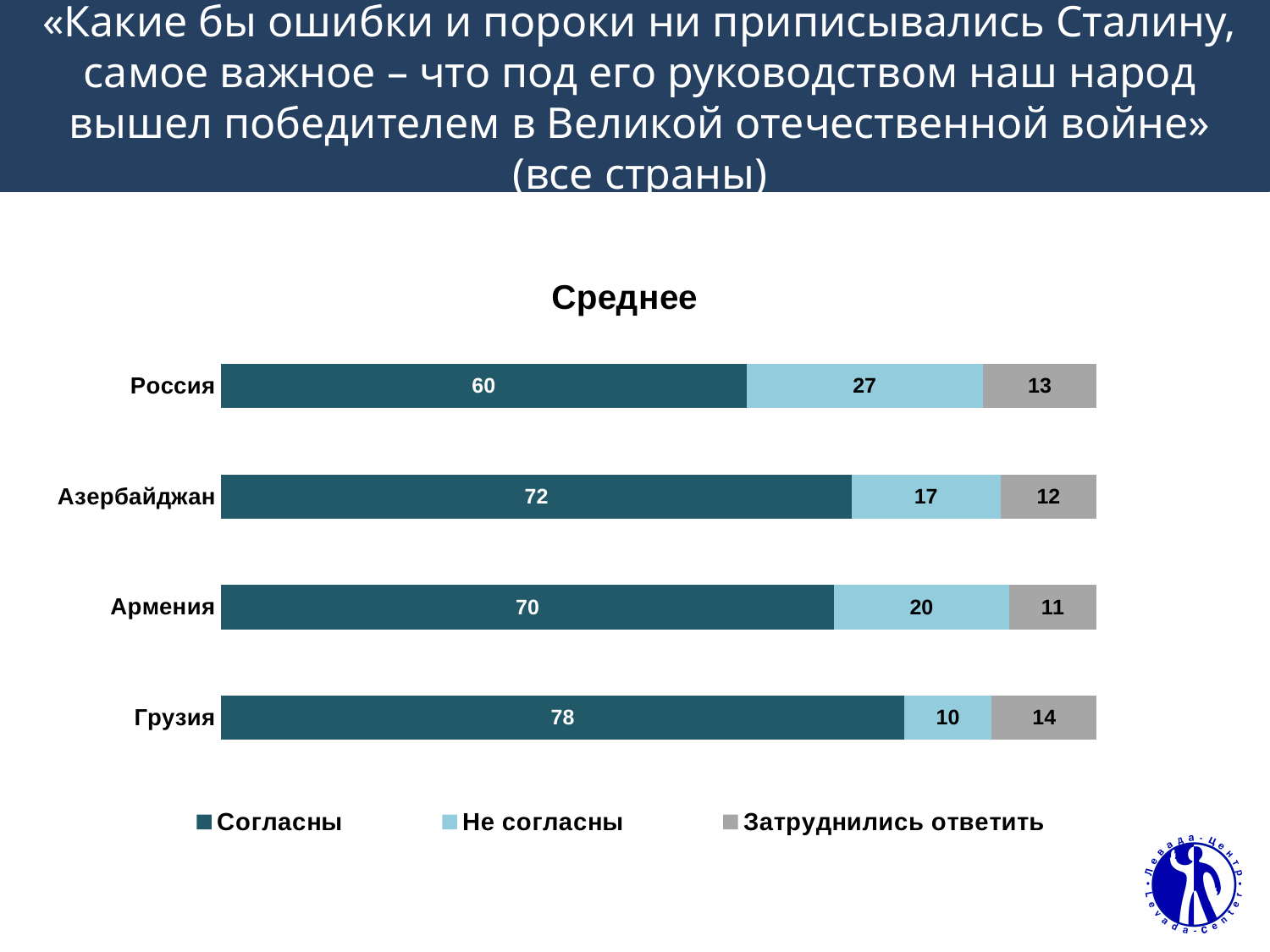
What is the title of the chart? Среднее Which country has the highest value for "Согласны"? Грузия Which is larger: the "Не согласны" value for Азербайджан or for Армения? Армения What is the value for "Затруднились ответить" for Армения? 11 What is the difference between the "Согласны" values for Грузия and Россия? 18 What is the value for "Согласны" for Россия? 60 How many countries are shown in the chart? 4 How many series does the legend list? 3 What is the total of the stacked bar for Азербайджан? 101 Which country has the lowest value for "Согласны"? Россия What is the value for "Не согласны" for Грузия? 10 What kind of chart is shown on the slide? Stacked bar chart